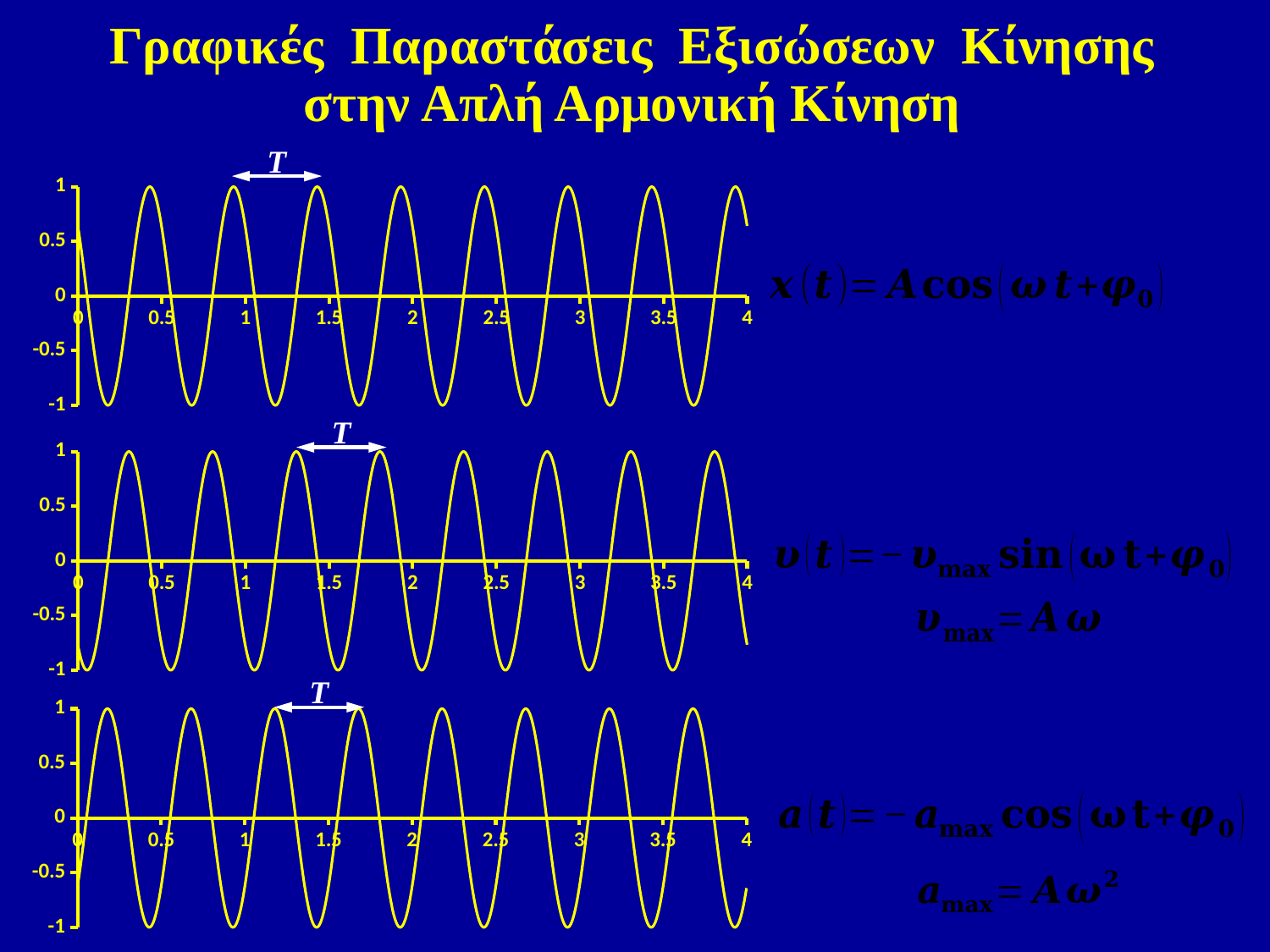
In the top chart, what is the highest value labelled on the vertical axis? 1 In the top chart, what is the lowest value labelled on the vertical axis? -1 In the bottom chart, is the value of the curve at t = 0 greater or less than 0.5? less In the middle chart, what is the largest value labelled on the horizontal axis? 4 How many charts are shown on the slide? 3 What letter labels the double-headed arrow drawn above each chart? T In the bottom chart, what is the maximum value the curve reaches? 1 In the top chart, is the value of the curve at t = 0 greater or less than 0.5? greater What kind of chart is the top chart on the slide? line chart In the middle chart, what is the minimum value the curve reaches? -1 Which equation is written next to the bottom chart? a(t) = -a_max cos(ωt + φ0)